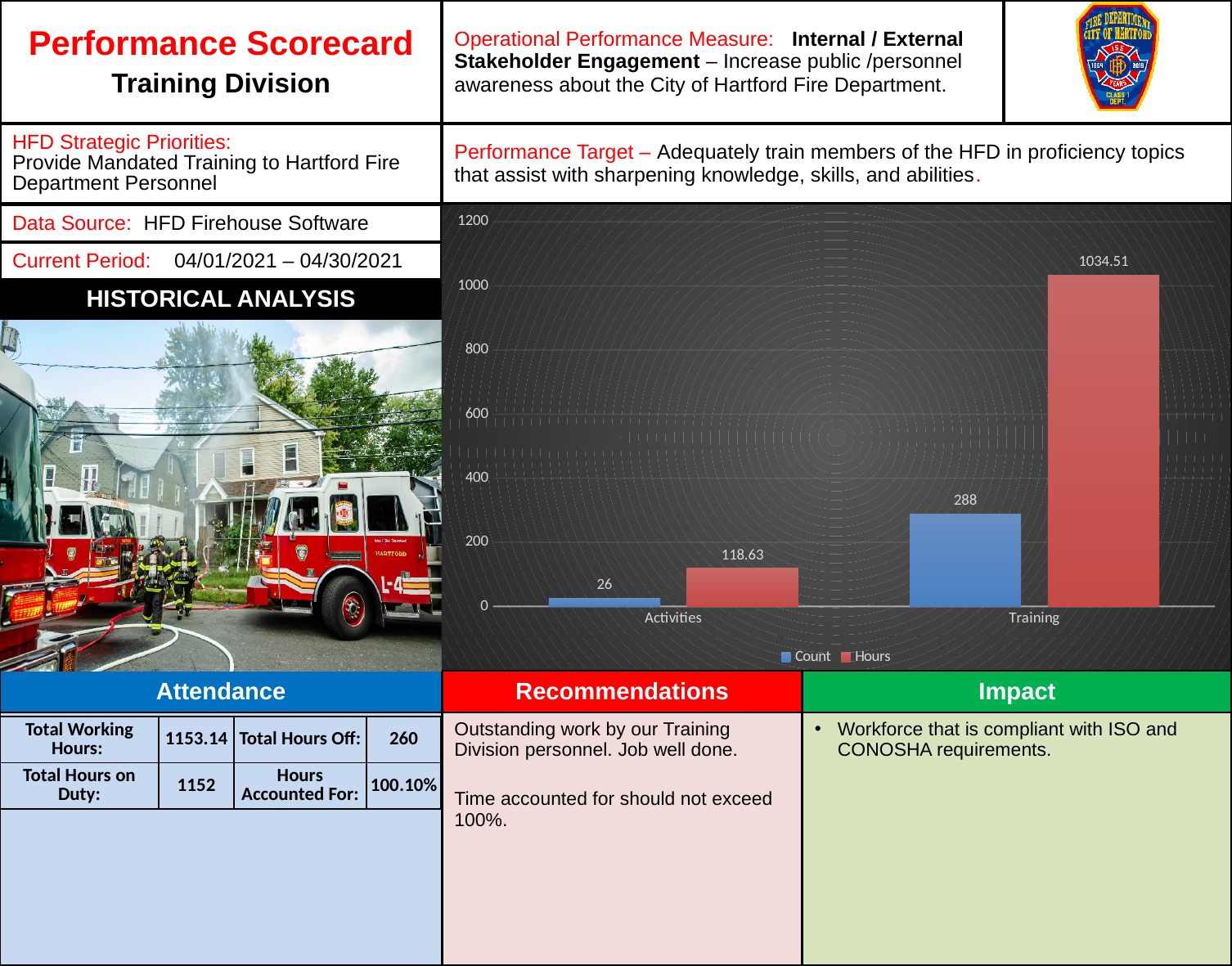
What kind of chart is shown on the slide? bar chart Which category has the highest Hours value? Training What is the Hours value for Activities? 118.63 Which category has the lowest Count value? Activities How many categories are shown on the x axis of the chart? 2 Is the Hours value for Training greater or less than 1000? greater What is the Count value for Activities? 26 Which is larger, the Hours value for Activities or the Count value for Training? Count value for Training What is the Count value for Training? 288 What is the difference between the Count values for Training and Activities? 262 What is the Hours value for Training? 1034.51 How many series does the chart legend list? 2